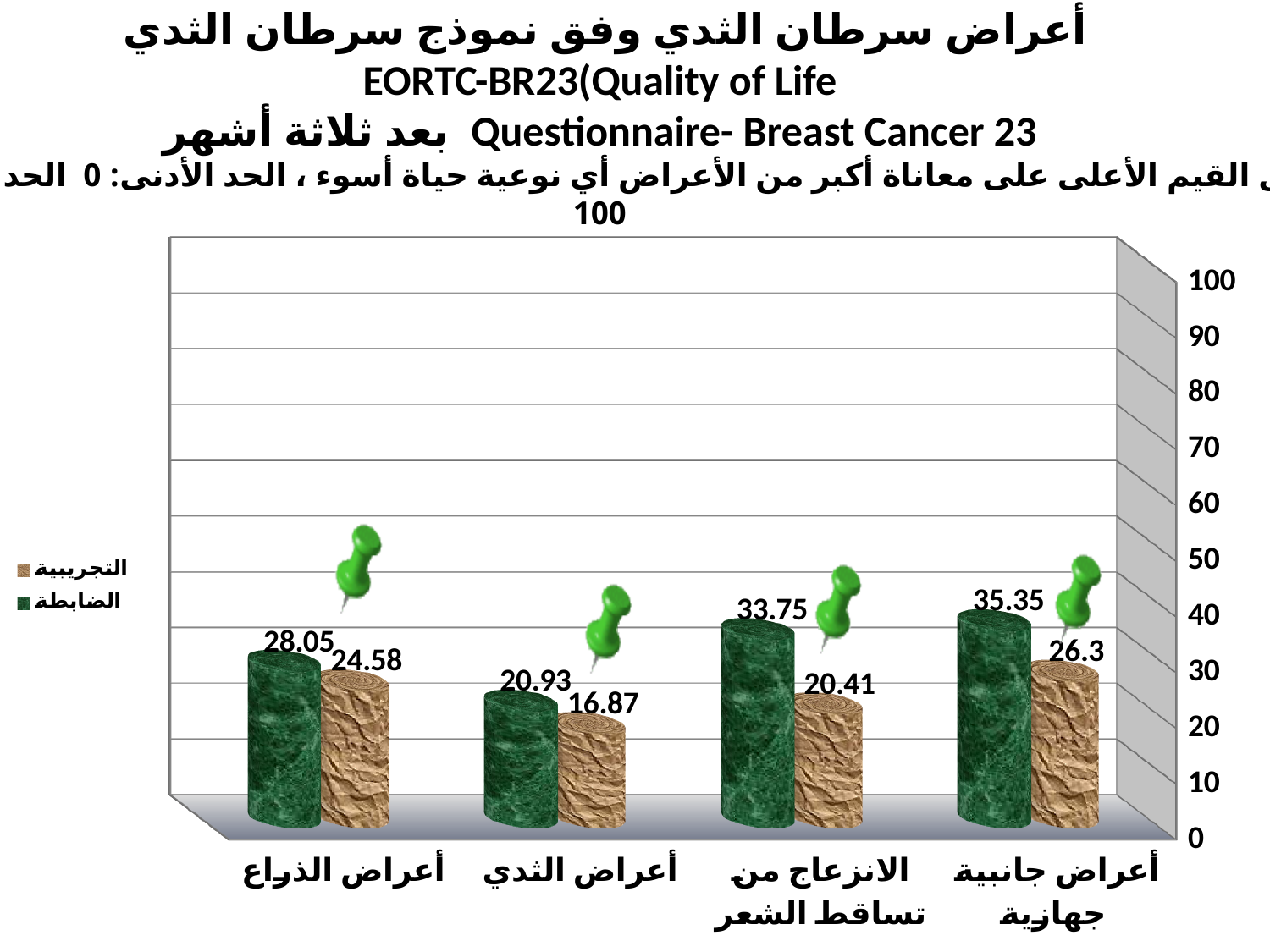
What kind of chart is shown on the slide? Bar chart Which category has the highest value for الضابطة? أعراض جانبية جهازية In the category أعراض الذراع, which series has the larger value, الضابطة or التجريبية? الضابطة What is the value for الضابطة in the category أعراض الذراع? 28.05 How many categories are shown on the x axis? 4 What is the difference between الضابطة and التجريبية in the category الانزعاج من تساقط الشعر? 13.34 What is the value for الضابطة in the category الانزعاج من تساقط الشعر? 33.75 Is the value for الضابطة in أعراض جانبية جهازية greater or less than 30? greater How many series does the legend list? 2 What is the value for التجريبية in the category أعراض الثدي? 16.87 What is the value for التجريبية in the category أعراض جانبية جهازية? 26.3 Which category has the lowest value for التجريبية? أعراض الثدي